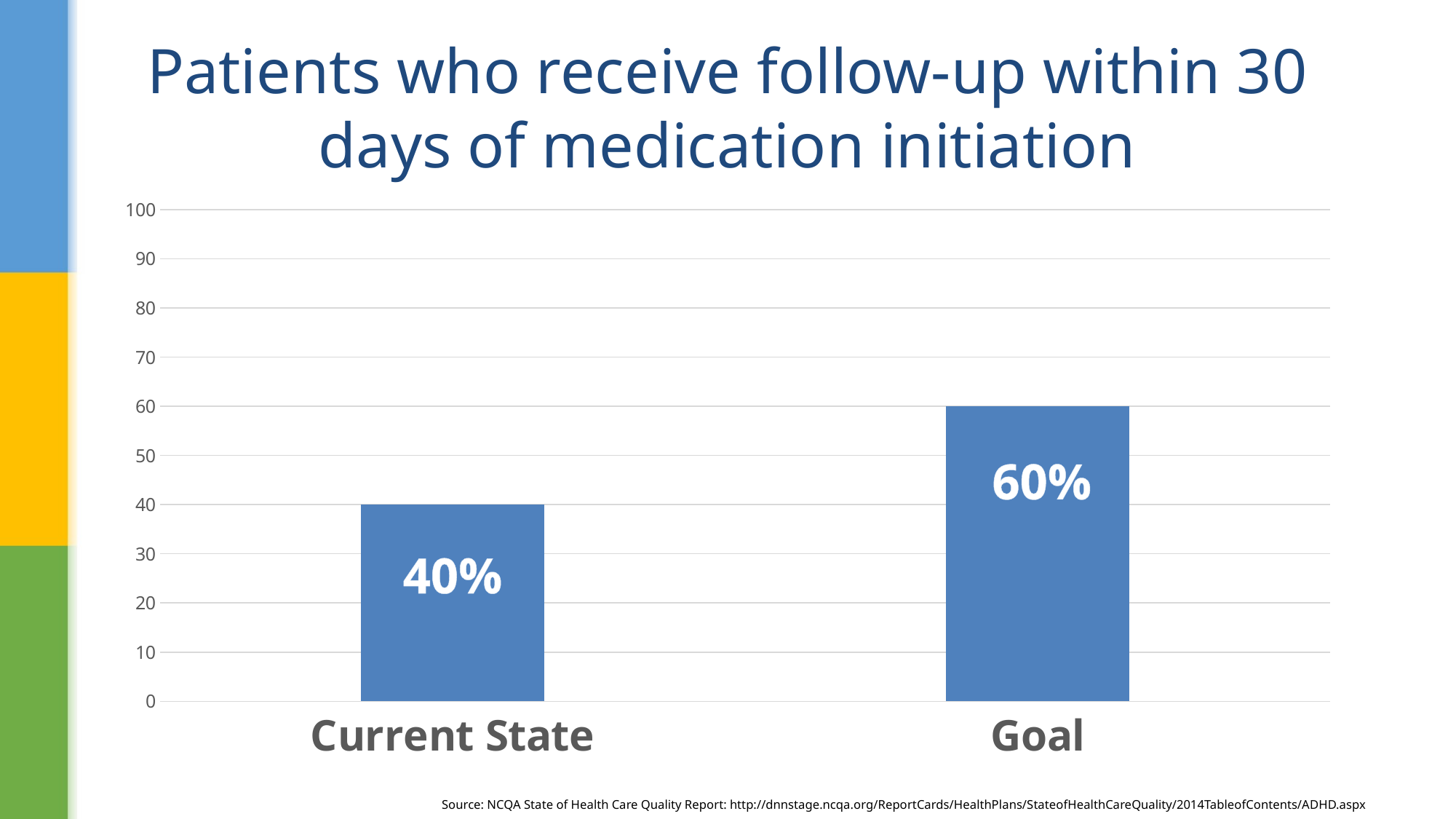
Which is larger, the value for Current State or the value for Goal? Goal What is the value for Current State? 40% How many categories are shown on the x axis? 2 Is the value for Goal greater or less than 50? greater Which category has the lowest value? Current State What kind of chart is shown on the slide? bar chart What is the title of the chart? Patients who receive follow-up within 30 days of medication initiation Which category has the highest value? Goal Is the value for Current State greater or less than 50? less What is the maximum value shown on the y axis? 100 What is the value for Goal? 60% What is the difference between the Goal value and the Current State value? 20%